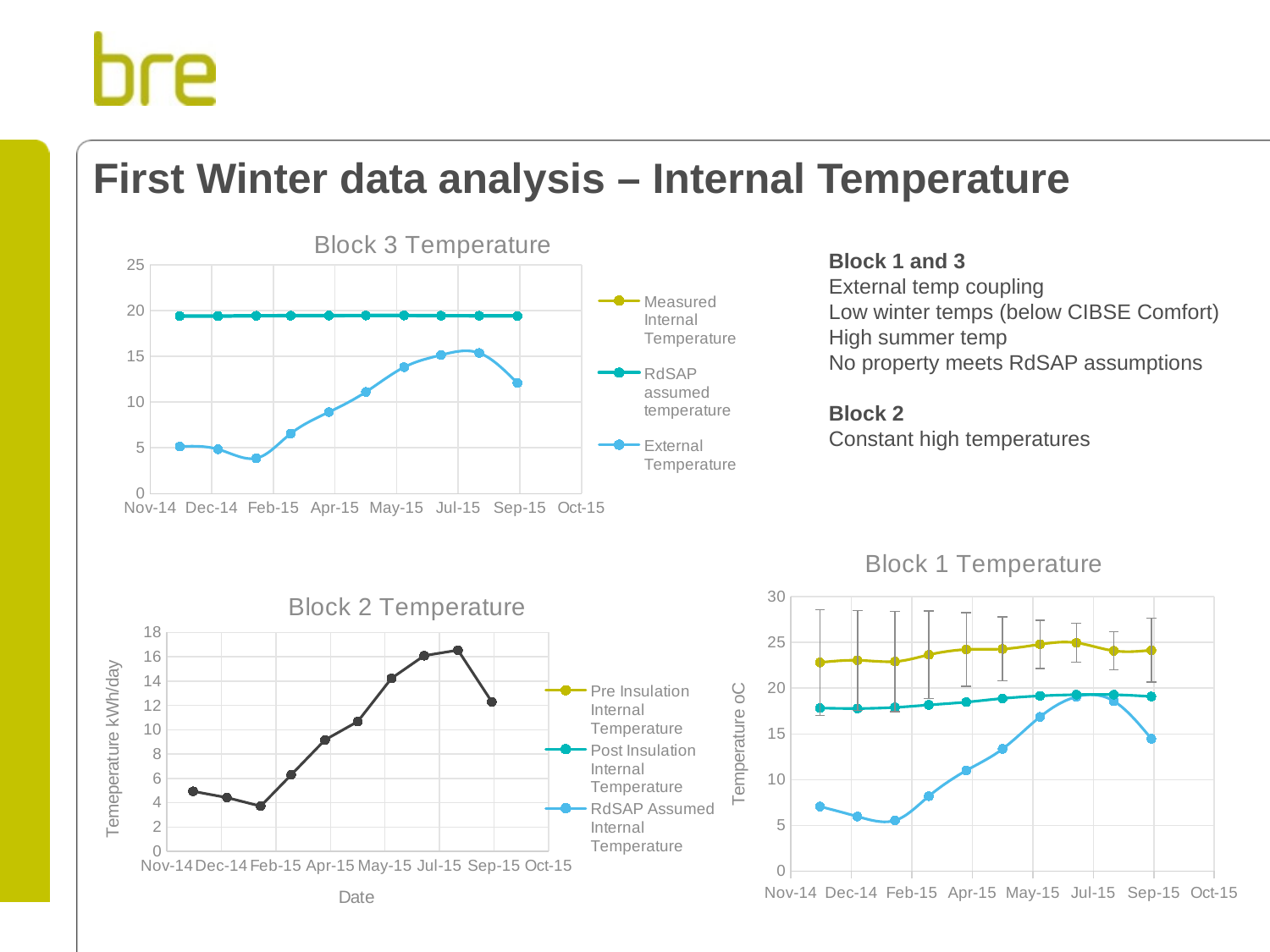
In the Block 2 Temperature chart, is the plotted value at Feb-15 greater or less than 5? less What kind of chart is the Block 3 Temperature chart? line chart How many series does the legend of the Block 3 Temperature chart list? 3 How many series does the legend of the Block 2 Temperature chart list? 3 In the Block 2 Temperature chart, is the plotted value at Jul-15 greater or less than 14? greater In the Block 3 Temperature chart, does the External Temperature rise or fall between Feb-15 and Jul-15? rise What is the x-axis title of the Block 2 Temperature chart? Date In the Block 3 Temperature chart, is the RdSAP assumed temperature greater or less than 15? greater What is the y-axis title of the Block 1 Temperature chart? Temperature oC